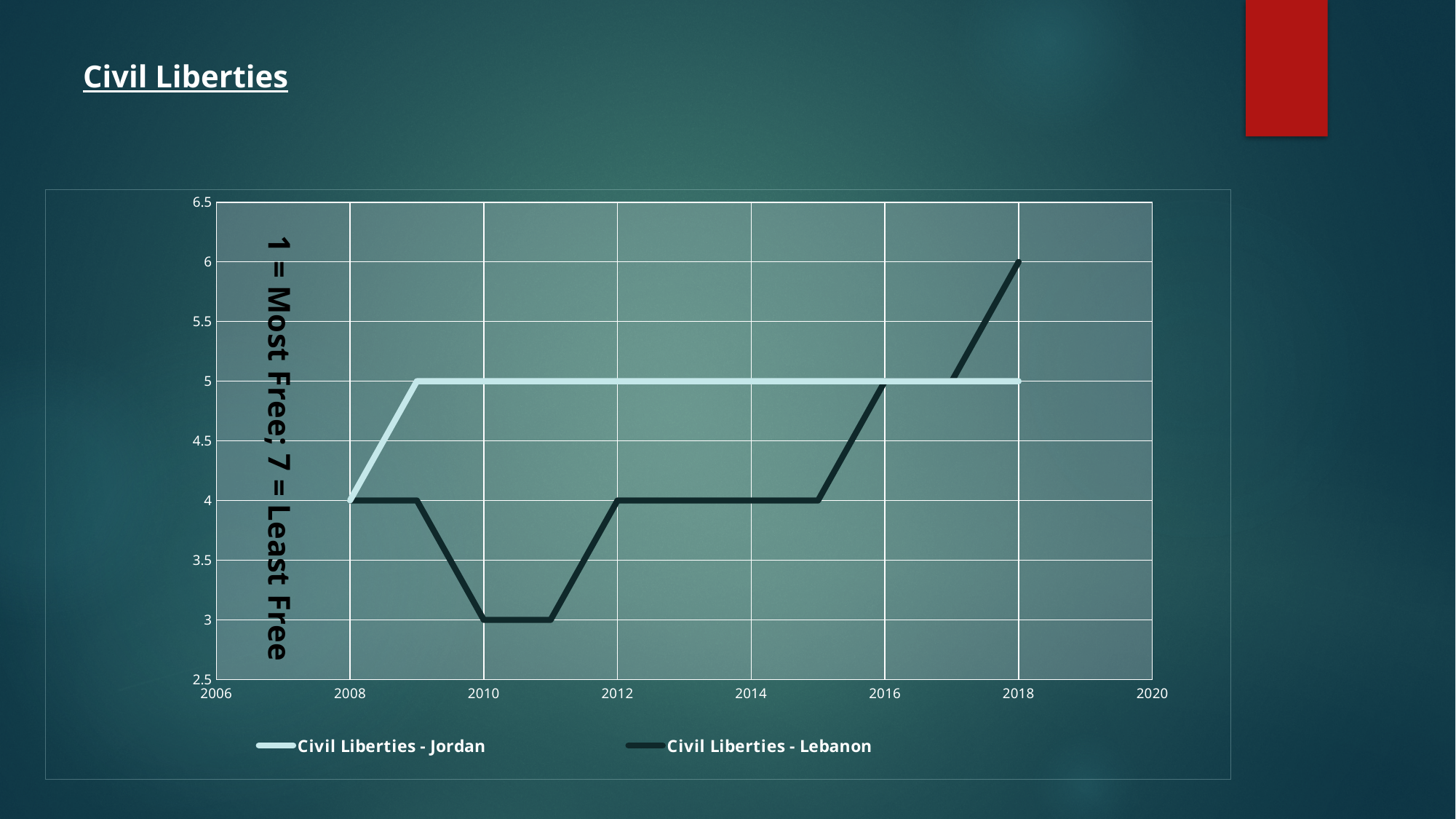
What is the lowest value reached by the Lebanon series? 3 What is the Civil Liberties value for Jordan in 2008? 4 How many series does the legend list? 2 What is the Civil Liberties value for Lebanon in 2018? 6 What does the text along the y axis say the scale means? 1 = Most Free; 7 = Least Free What is the Civil Liberties value for Lebanon in 2014? 4 In which year does the Lebanon series reach its highest value? 2018 What is the difference between the Lebanon value in 2018 and the Jordan value in 2018? 1 What is the Civil Liberties value for Jordan in 2012? 5 What is the Civil Liberties value for Lebanon in 2010? 3 In 2011, which series has the larger value, Jordan or Lebanon? Jordan What kind of chart is shown on the slide? line chart